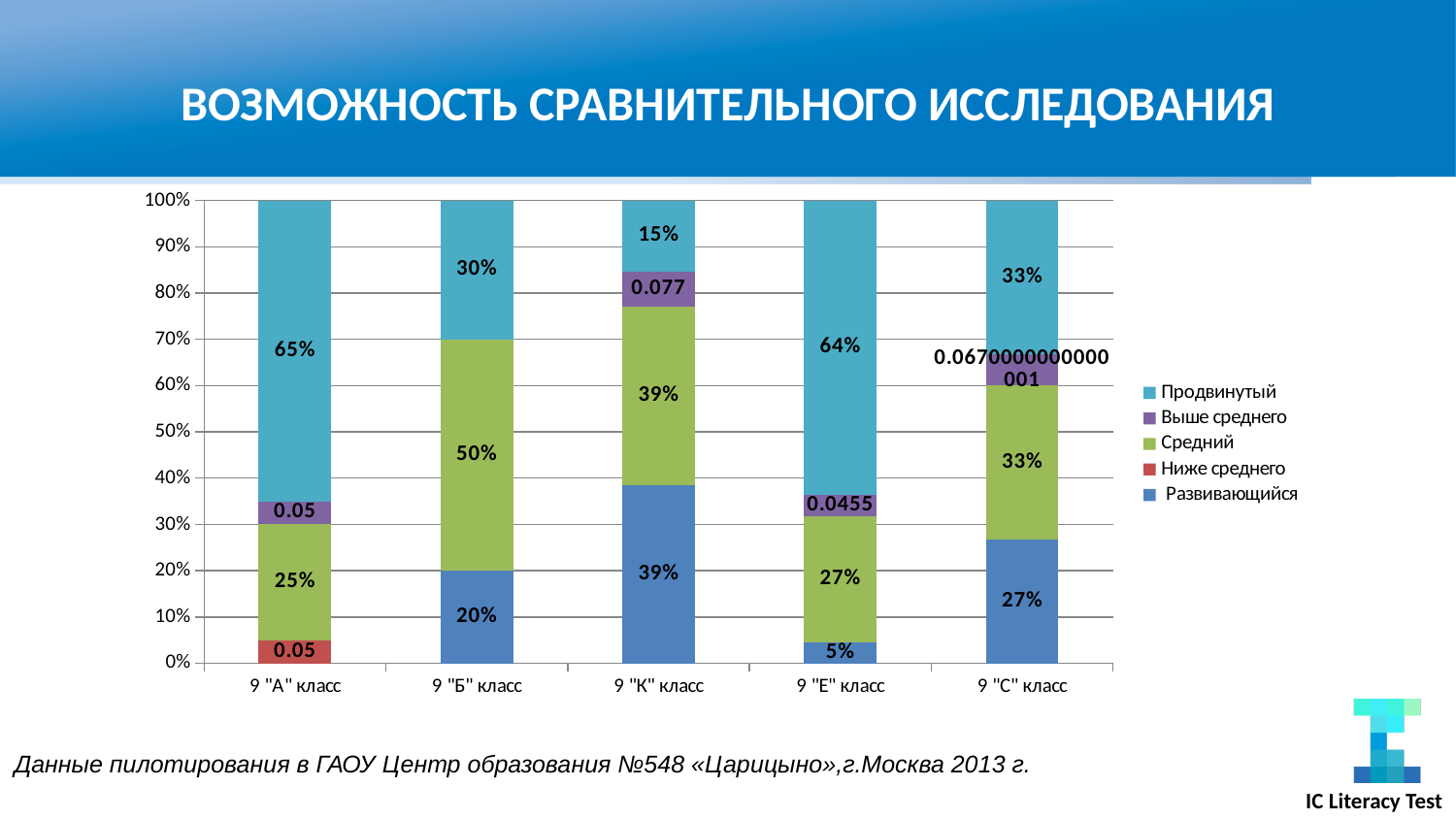
What is the value of the Выше среднего segment for 9 "Е" класс? 0.0455 Which class has the smallest Продвинутый segment? 9 "К" класс What is the value of the Развивающийся segment for 9 "К" класс? 39% What is the value of the Продвинутый segment for 9 "А" класс? 65% What is the value of the Развивающийся segment for 9 "С" класс? 27% How many series does the legend list? 5 Which class has the largest Продвинутый segment? 9 "А" класс What kind of chart is shown on the slide? Stacked bar chart Which is larger: the Средний segment for 9 "Б" класс or for 9 "С" класс? 9 "Б" класс What is the value of the Средний segment for 9 "Б" класс? 50% How many classes (categories) are shown on the x axis? 5 Which class is the only one with a Ниже среднего segment? 9 "А" класс